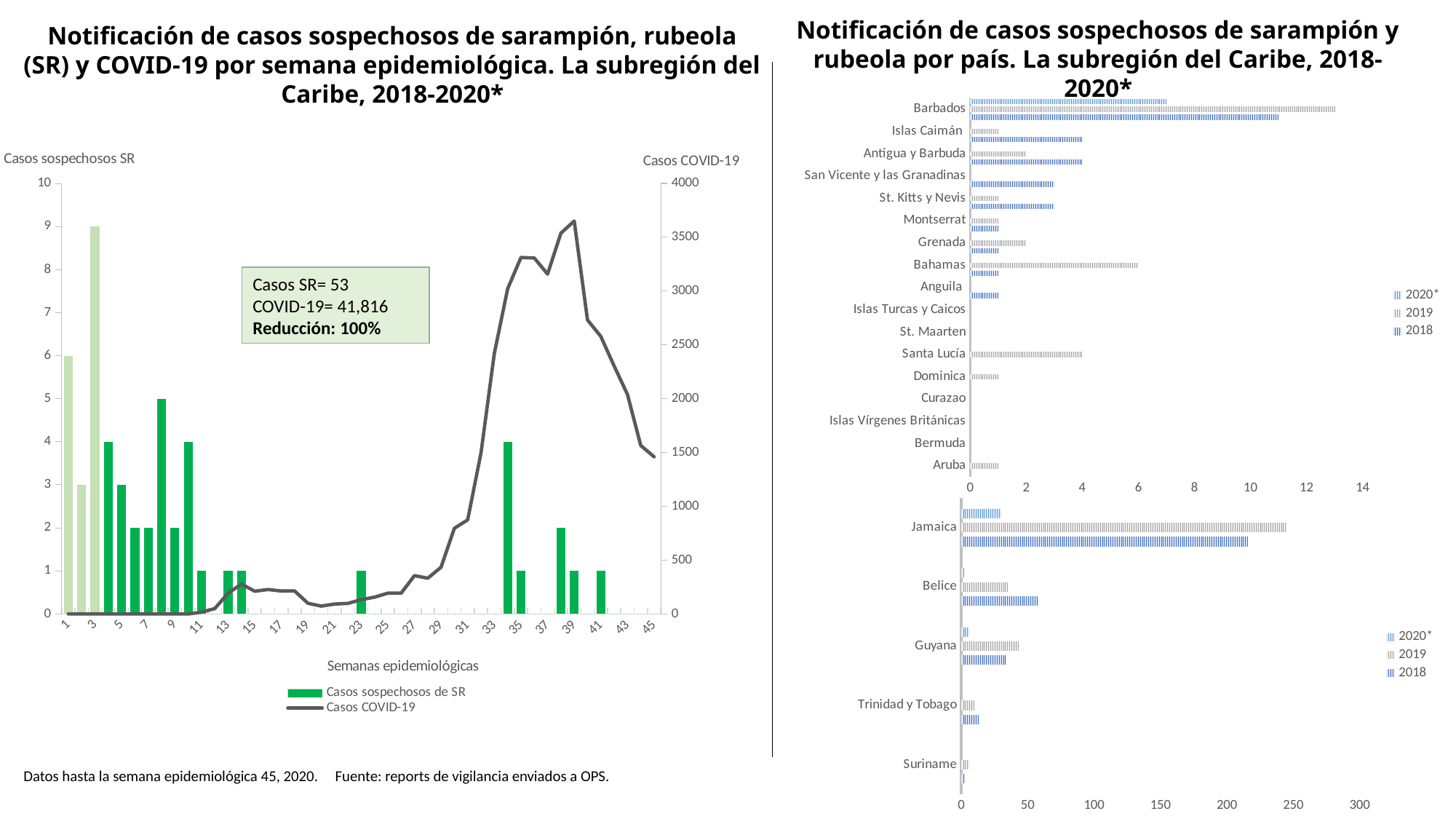
On the left chart, is the number of COVID-19 cases at week 39 greater or less than 3500? greater On the top-right chart, which country has the highest value for 2019? Barbados On the left chart, how many series does the legend list? 2 On the top-right chart, how many countries are listed on the vertical axis? 17 On the left chart, what total of COVID-19 cases is given in the text box? 41,816 On the left chart, how many suspected SR cases are shown for epidemiological week 1? 6 On the left chart, how many suspected SR cases are shown for epidemiological week 3? 9 On the left chart (casos sospechosos de SR y COVID-19 por semana epidemiológica), what kind of chart is used for the 'Casos sospechosos de SR' series? bar chart On the left chart, what total of suspected SR cases is given in the text box? 53 On the bottom-right chart, is the 2019 value for Jamaica greater or less than 200? greater On the left chart, in which epidemiological week is the number of suspected SR cases highest? 3 On the top-right chart (casos sospechosos de sarampión y rubeola por país), how many series does the legend list? 3